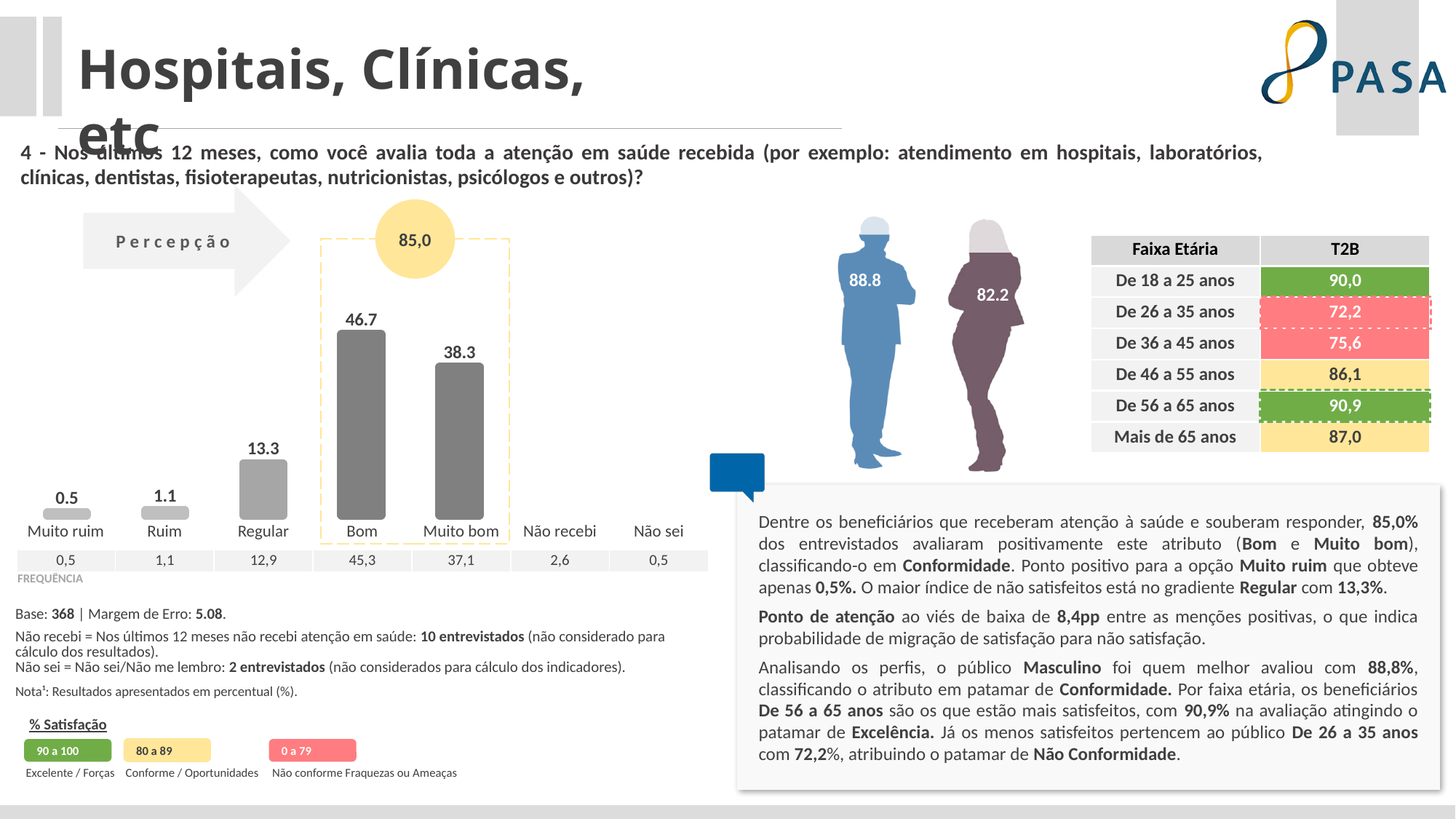
Which is larger in the chart, the Regular bar or the Ruim bar? Regular What is the difference between the Bom and Muito bom bars in the chart? 8.4 How many category labels are shown along the x axis of the chart? 7 What value is shown in the yellow circle above the dashed box around Bom and Muito bom? 85,0 What is the value shown for the Muito ruim bar in the chart? 0.5 Which category has the lowest bar in the chart? Muito ruim What is the value shown for the Regular bar in the chart? 13.3 What is the value shown for the Muito bom bar in the chart? 38.3 What type of chart is shown on the slide? Bar chart Which category has the highest bar in the chart? Bom What is the frequency value shown below the Não recebi category in the chart? 2,6 What is the value shown for the Bom bar in the chart? 46.7